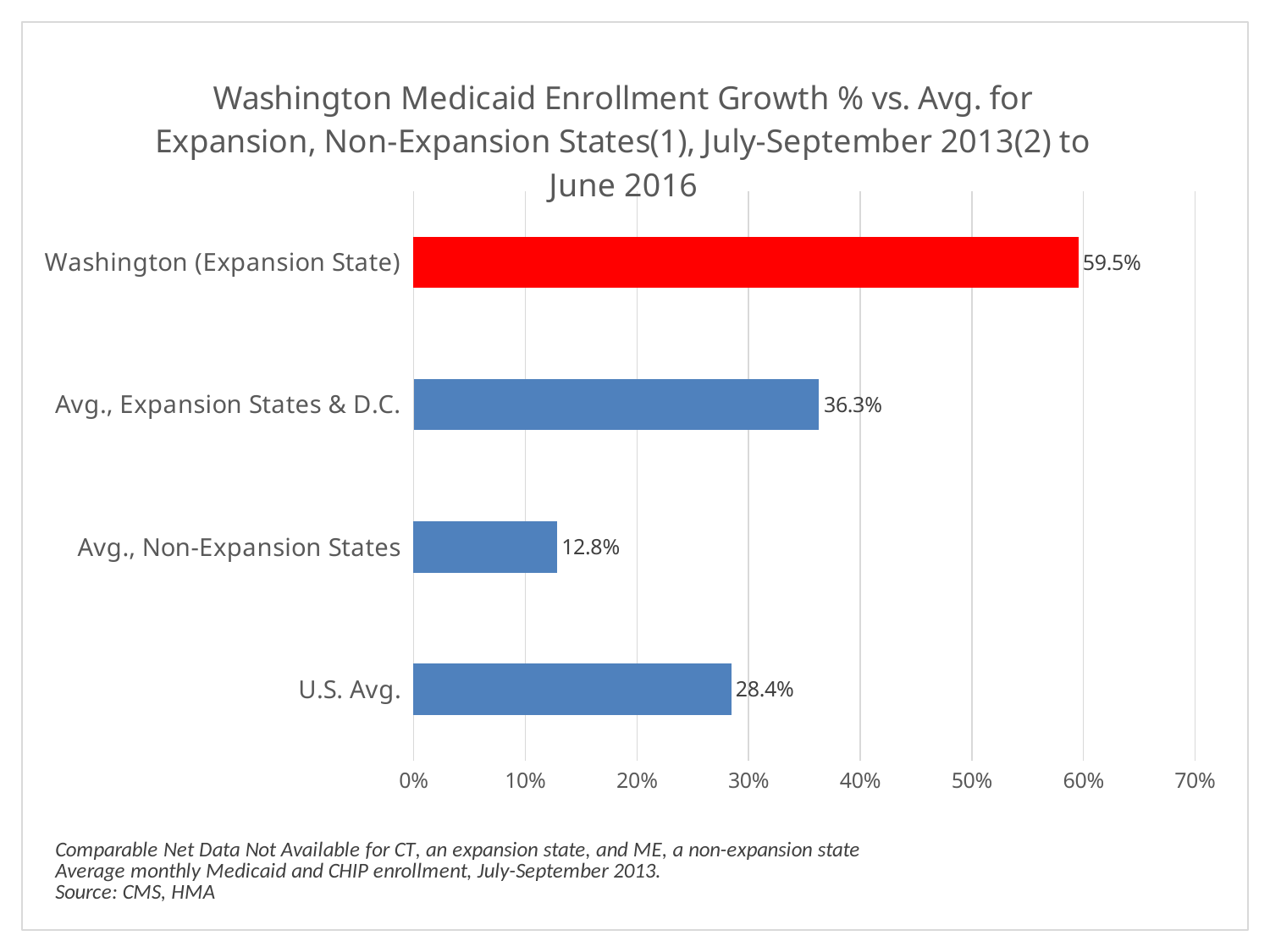
How many categories are shown in the chart? 4 What is the difference between Washington (Expansion State) and Avg., Expansion States & D.C.? 23.2% What is the Medicaid enrollment growth value for Washington (Expansion State)? 59.5% Which is larger, the value for U.S. Avg. or the value for Avg., Expansion States & D.C.? Avg., Expansion States & D.C. Is the value for Washington (Expansion State) greater or less than 50%? greater What is the value for U.S. Avg.? 28.4% What kind of chart is shown on the slide? Bar chart What is the value for Avg., Non-Expansion States? 12.8% What is the value for Avg., Expansion States & D.C.? 36.3% Which category has the lowest enrollment growth? Avg., Non-Expansion States Which category has the highest enrollment growth? Washington (Expansion State) What is the difference between U.S. Avg. and Avg., Non-Expansion States? 15.6%